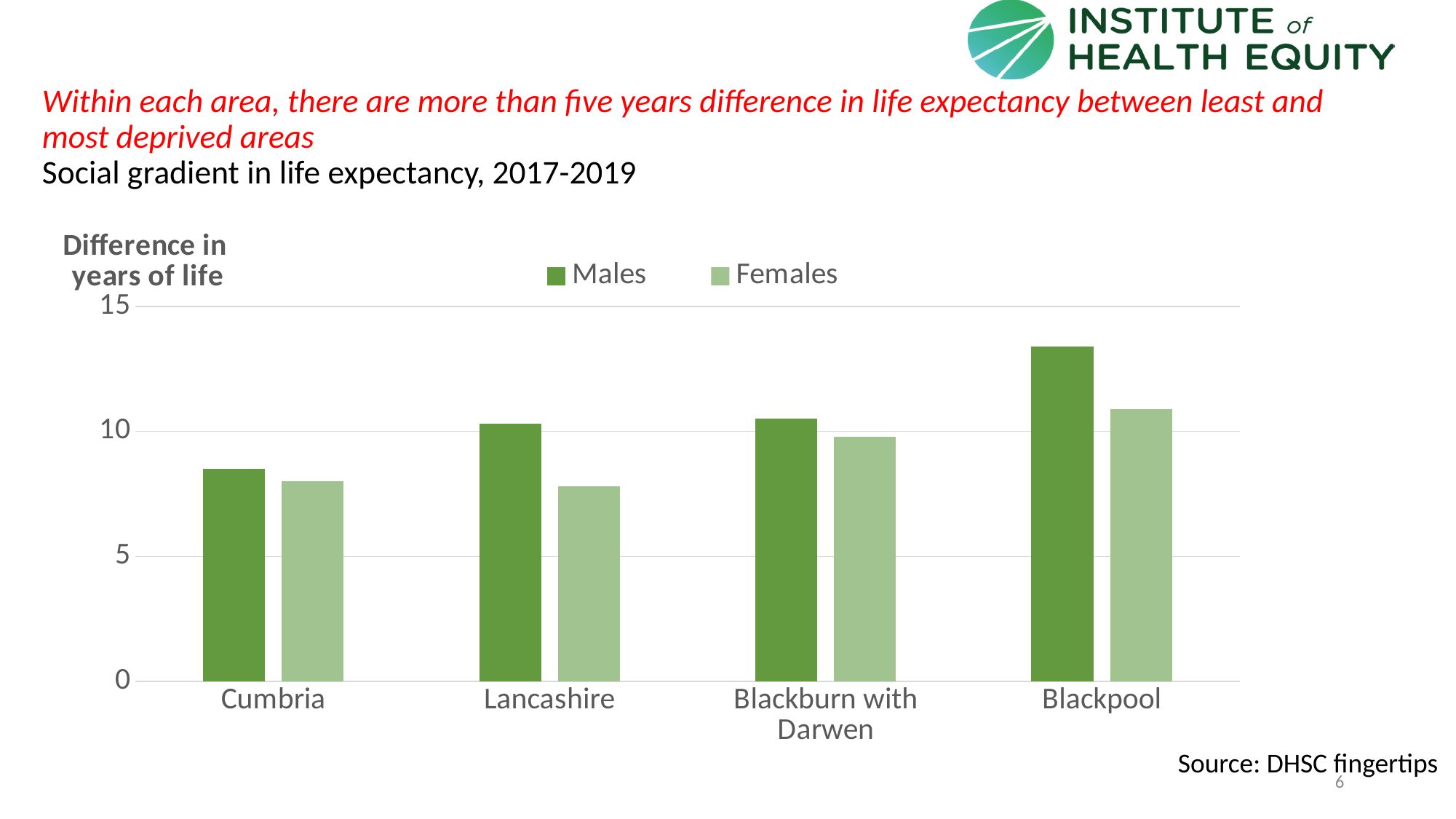
Is the value for Males in Blackpool greater or less than 10? greater How many series does the chart's legend list? 2 Which area has the highest value for Males? Blackpool What kind of chart is shown on the slide? bar chart What is the title of the chart? Social gradient in life expectancy, 2017-2019 Is the value for Females in Lancashire greater or less than 10? less Which area has the lowest value for Males? Cumbria How many areas are shown on the x axis of the chart? 4 Is the value for Males in Cumbria greater or less than 10? less Which area has the highest value for Females? Blackpool Which is larger: the Females value for Blackburn with Darwen or the Females value for Lancashire? Blackburn with Darwen Do the Males values rise or fall moving from Cumbria to Blackpool along the x axis? rise